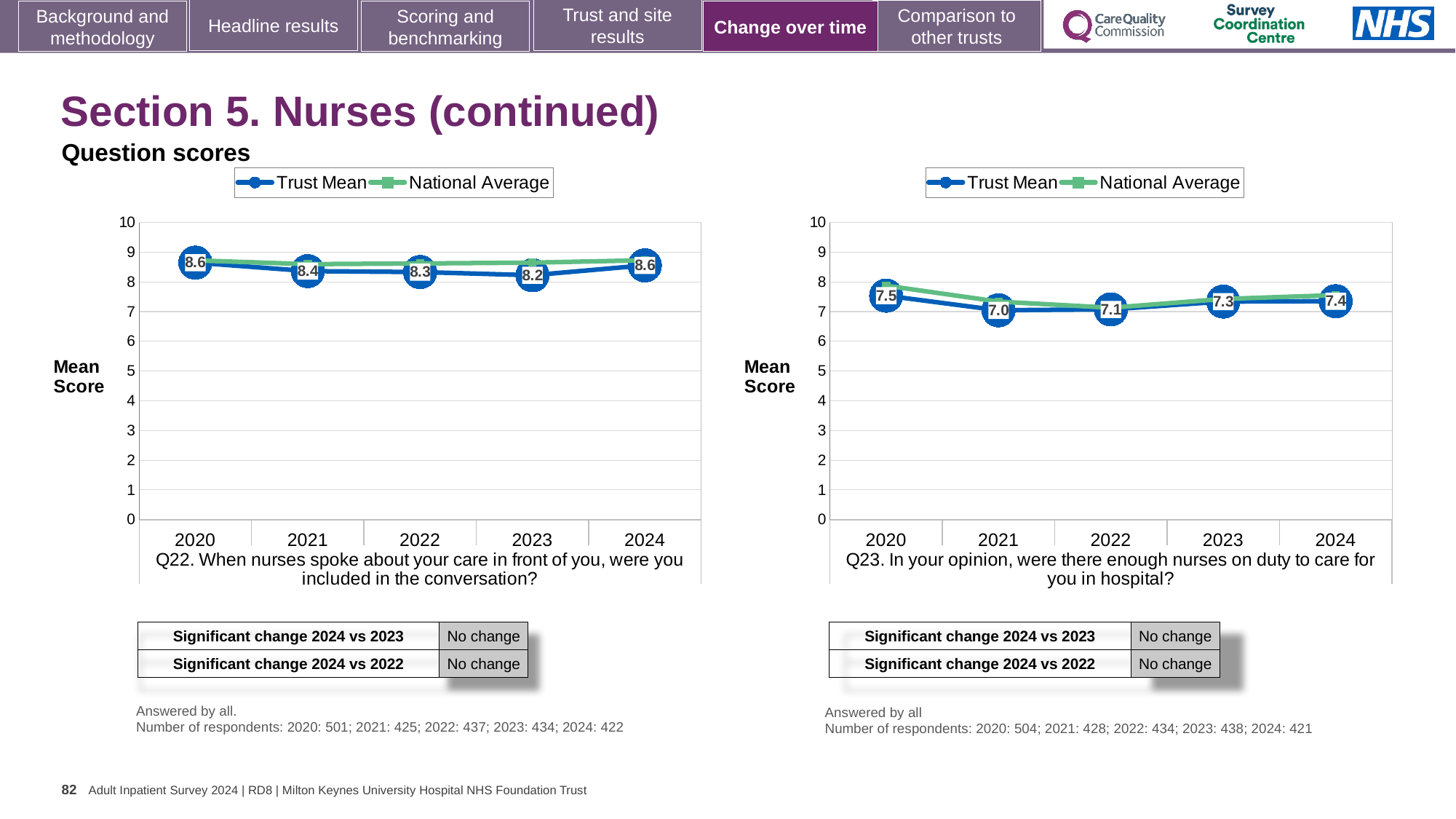
On the Q23 chart (right), is the National Average value for 2020 greater or less than 7? greater On the Q22 chart (left), what is the difference between the Trust Mean scores for 2020 and 2023? 0.4 On the Q22 chart (left), what is the Trust Mean score for 2024? 8.6 On the Q22 chart (left), what is the Trust Mean score for 2023? 8.2 What type of chart is the Q22 chart (left)? Line chart On the Q23 chart (right), which year has the highest Trust Mean score? 2020 How many years are plotted on the x axis of the Q22 chart (left)? 5 How many series does the legend of the Q23 chart (right) list? 2 On the Q23 chart (right), what is the Trust Mean score for 2021? 7.0 On the Q22 chart (left), which year has the lowest Trust Mean score? 2023 On the Q23 chart (right), is the Trust Mean score for 2024 larger or smaller than the Trust Mean score for 2021? larger On the Q23 chart (right), what is the difference between the Trust Mean scores for 2020 and 2021? 0.5